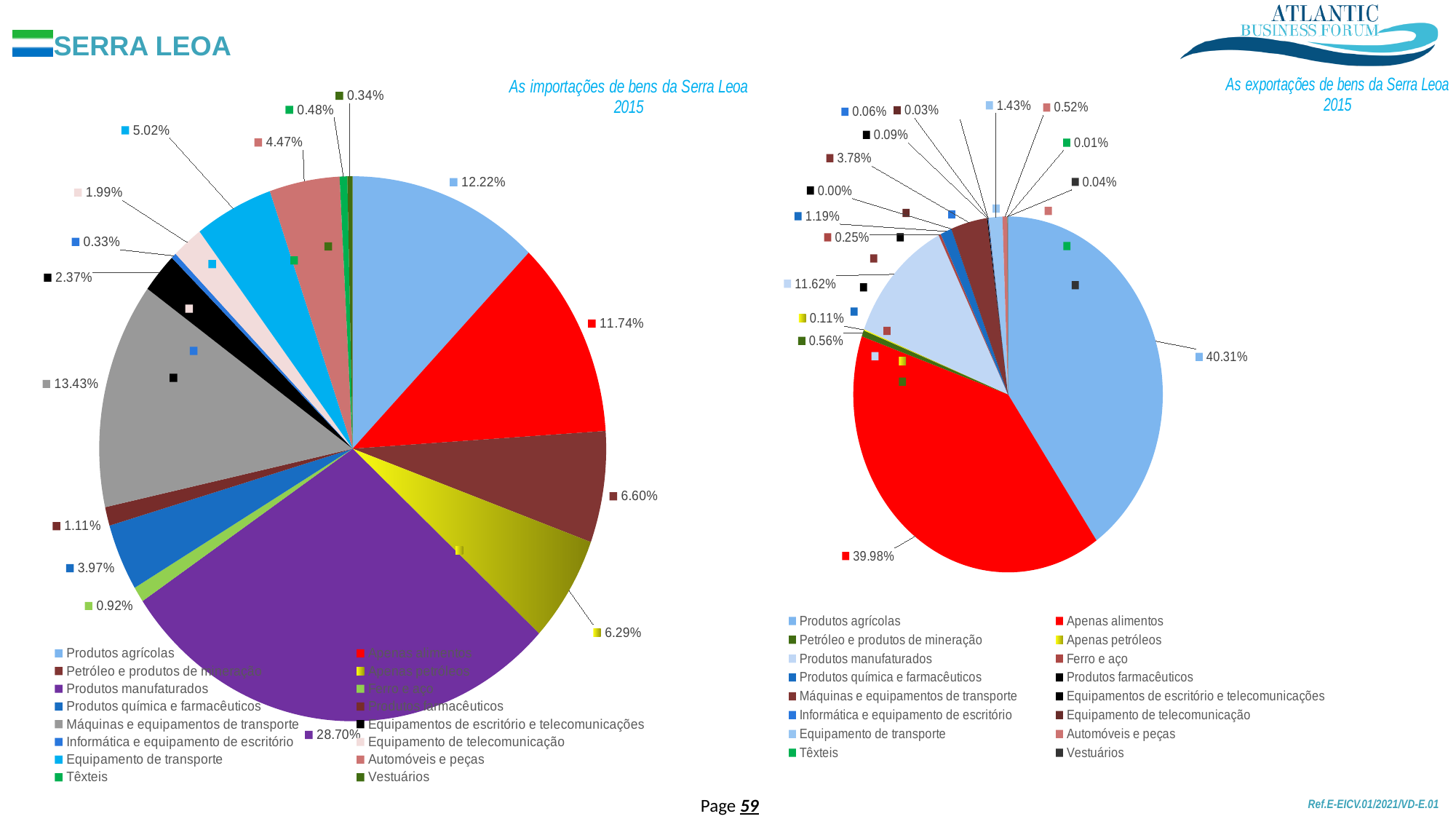
In the imports chart (left), what share is shown for Máquinas e equipamentos de transporte? 13.43% In the imports chart (left), what is the difference between the shares of Produtos agrícolas (12.22%) and Apenas alimentos (11.74%)? 0.48% What kind of chart is used for 'As importações de bens da Serra Leoa 2015'? pie chart In the exports chart (right), what share is shown for Apenas alimentos? 39.98% In the exports chart (right), which is larger: the share of Produtos manufaturados or the share of Máquinas e equipamentos de transporte? Produtos manufaturados In the imports chart (left), which category has the largest share? Produtos manufaturados How many categories does the legend of the exports chart (right) list? 16 In the imports chart (left), what share is shown for Produtos manufaturados? 28.70% What is the title of the chart on the right? As exportações de bens da Serra Leoa 2015 In the exports chart (right), what share is shown for Produtos agrícolas? 40.31% In the exports chart (right), what is the combined share of Produtos agrícolas (40.31%) and Apenas alimentos (39.98%)? 80.29% In the exports chart (right), what share is shown for Produtos manufaturados? 11.62%